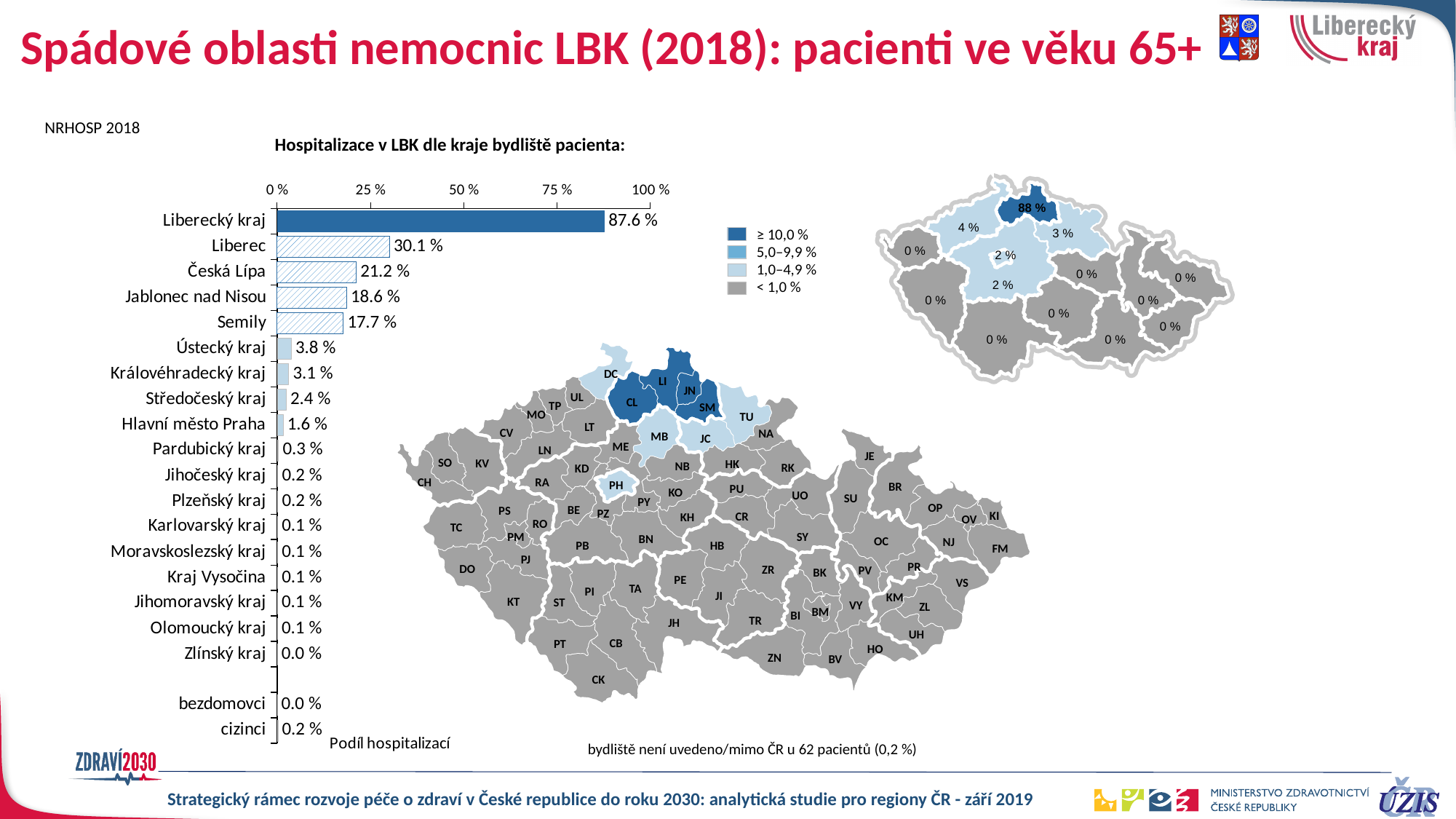
What is the value for Ústecký kraj in the bar chart? 3.8 % What is the value for Liberecký kraj in the bar chart 'Hospitalizace v LBK dle kraje bydliště pacienta'? 87.6 % What kind of chart is used to show 'Hospitalizace v LBK dle kraje bydliště pacienta'? bar chart What is the difference between the values for Jablonec nad Nisou and Semily in the bar chart? 0.9 % What is the highest tick value shown on the x axis of the bar chart? 100 % What is the value for cizinci in the bar chart? 0.2 % Is the value for Liberecký kraj in the bar chart greater or less than 75 %? greater How many categories are shown in the bar chart? 20 Which category has the highest value in the bar chart? Liberecký kraj Which has a larger value in the bar chart, Královéhradecký kraj or Středočeský kraj? Královéhradecký kraj What is the value for Česká Lípa in the bar chart? 21.2 % What is the difference between the values for Liberec and Česká Lípa in the bar chart? 8.9 %